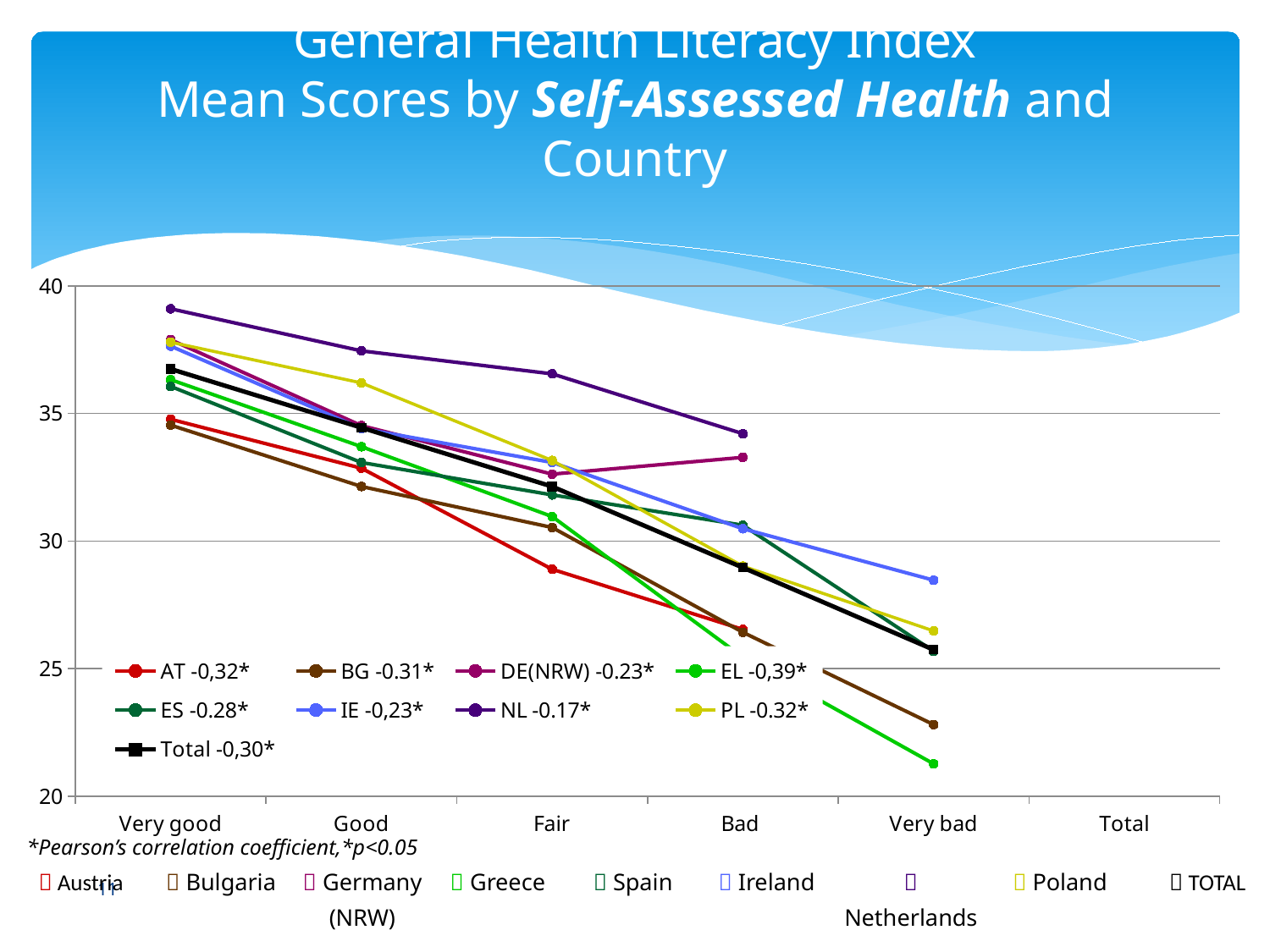
Which series has the highest value at the 'Very good' category? NL -0.17* Is the value for Total at 'Bad' greater or less than 30? less At the 'Very bad' category, which is higher: IE or BG? IE What kind of chart is shown on the slide? line chart How many category labels appear along the x axis of the chart? 6 Which series has the lowest value at the 'Very bad' category? EL -0,39* Is the value for NL at 'Very good' greater or less than 35? greater How many series does the chart legend list? 9 What is the title of the chart on the slide? General Health Literacy Index Mean Scores by Self-Assessed Health and Country Does the Total series rise or fall from 'Very good' to 'Very bad'? fall Which series has the lowest value at the 'Fair' category? AT -0,32* Is the value for EL at 'Very bad' greater or less than 25? less